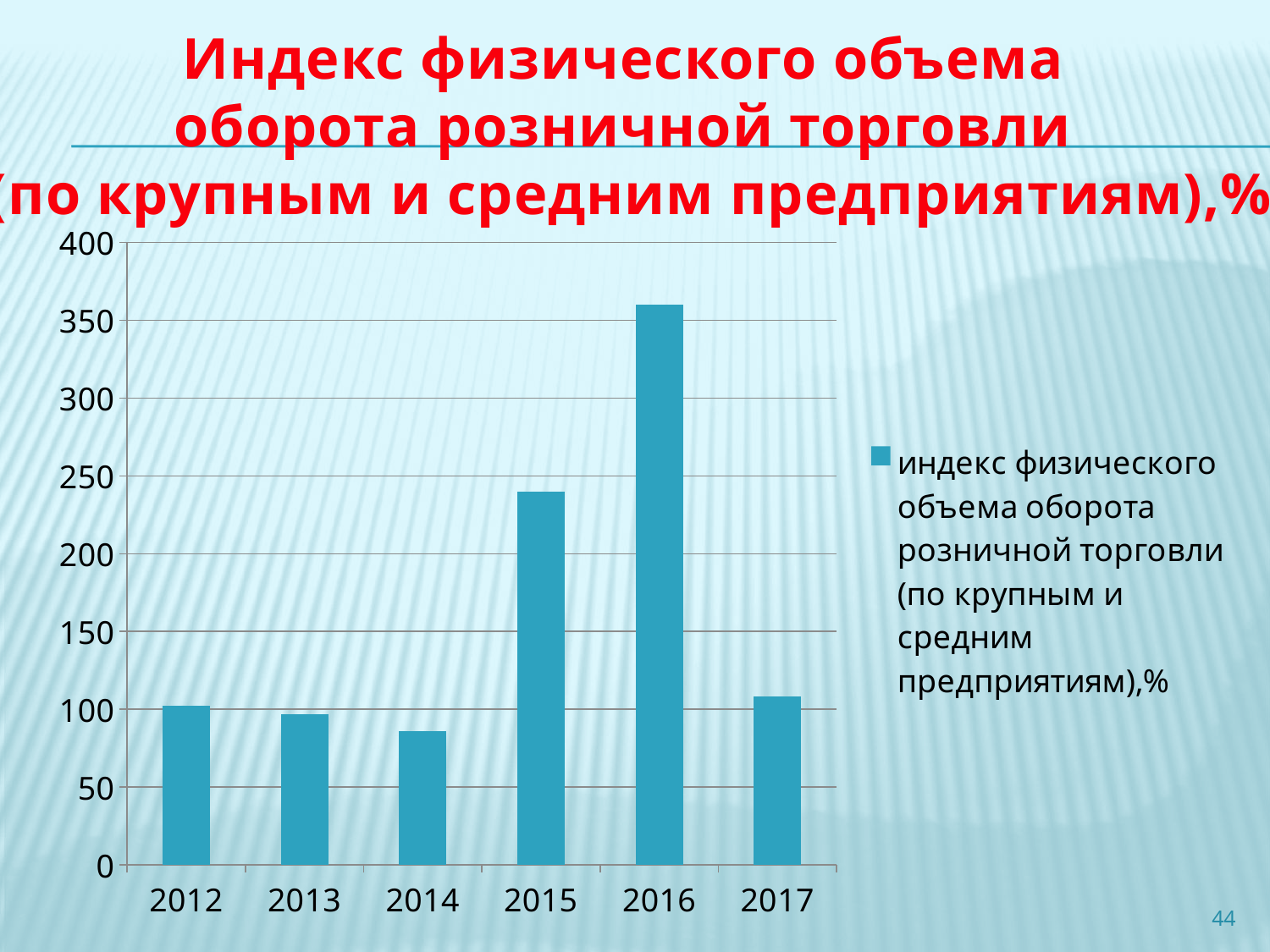
Which year has the highest value in the chart? 2016 Is the value for 2015 greater or less than 250? less Which is larger, the value for 2015 or the value for 2016? 2016 How many years are shown on the x axis of the chart? 6 Is the value for 2015 greater or less than 200? greater What is the first year shown on the x axis? 2012 What kind of chart is shown on the slide? bar chart Which year has the lowest value in the chart? 2014 Do the values rise or fall from 2014 to 2016? rise Is the value for 2014 greater or less than 100? less How many series does the legend list? 1